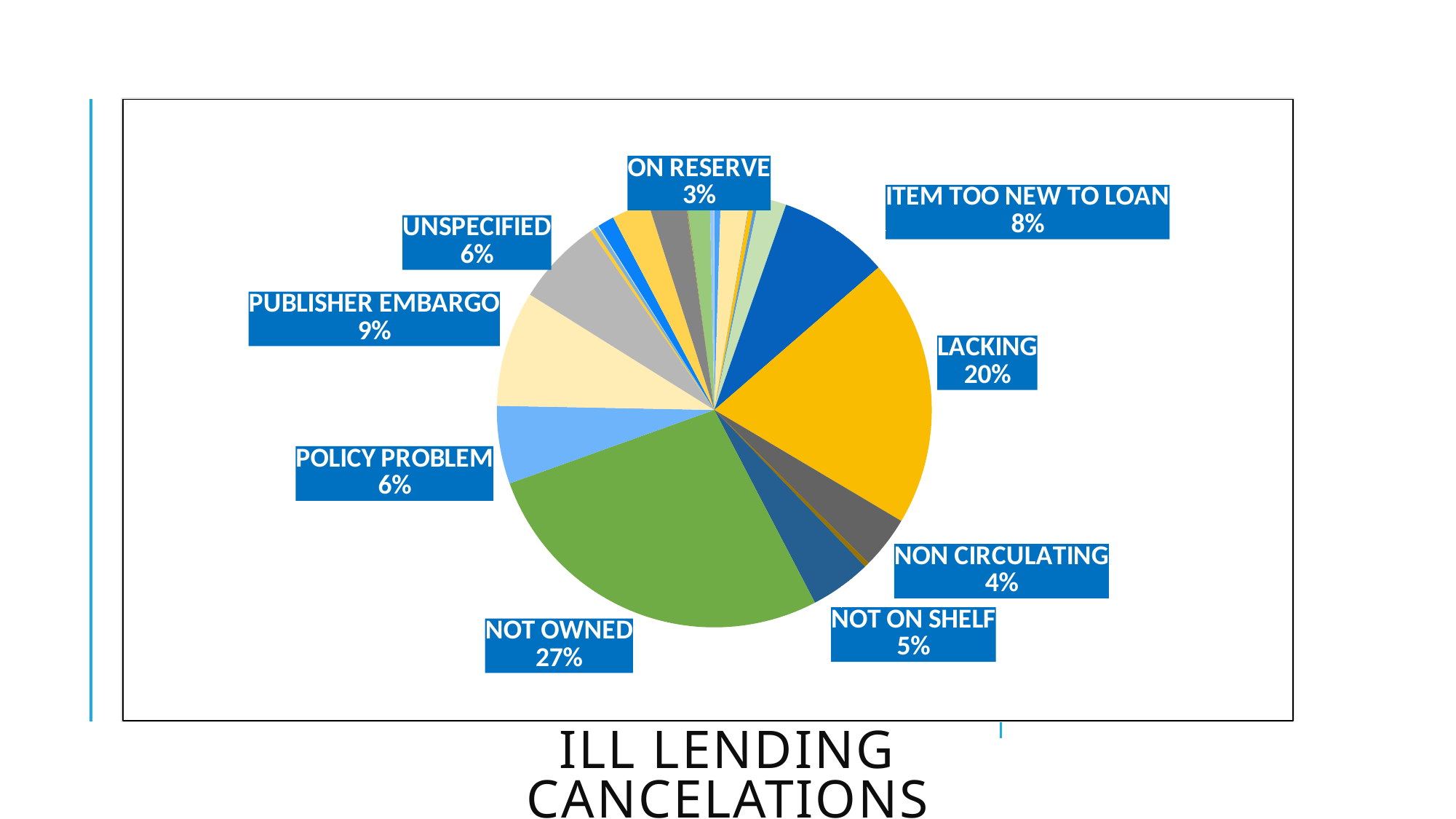
What is the title of the chart? ILL LENDING CANCELATIONS What percentage is shown for PUBLISHER EMBARGO? 9% What share of ILL lending cancelations is labeled NOT OWNED? 27% Which is larger, the share for LACKING or the share for PUBLISHER EMBARGO? LACKING What is the combined share of POLICY PROBLEM and UNSPECIFIED? 12% What kind of chart is shown on the slide? pie chart Which labeled category has the largest slice of the pie? NOT OWNED What percentage is shown for ON RESERVE? 3% What percentage is shown for NON CIRCULATING? 4% What percentage is shown for LACKING? 20% What percentage is shown for ITEM TOO NEW TO LOAN? 8% By how many percentage points does NOT OWNED exceed LACKING? 7 percentage points